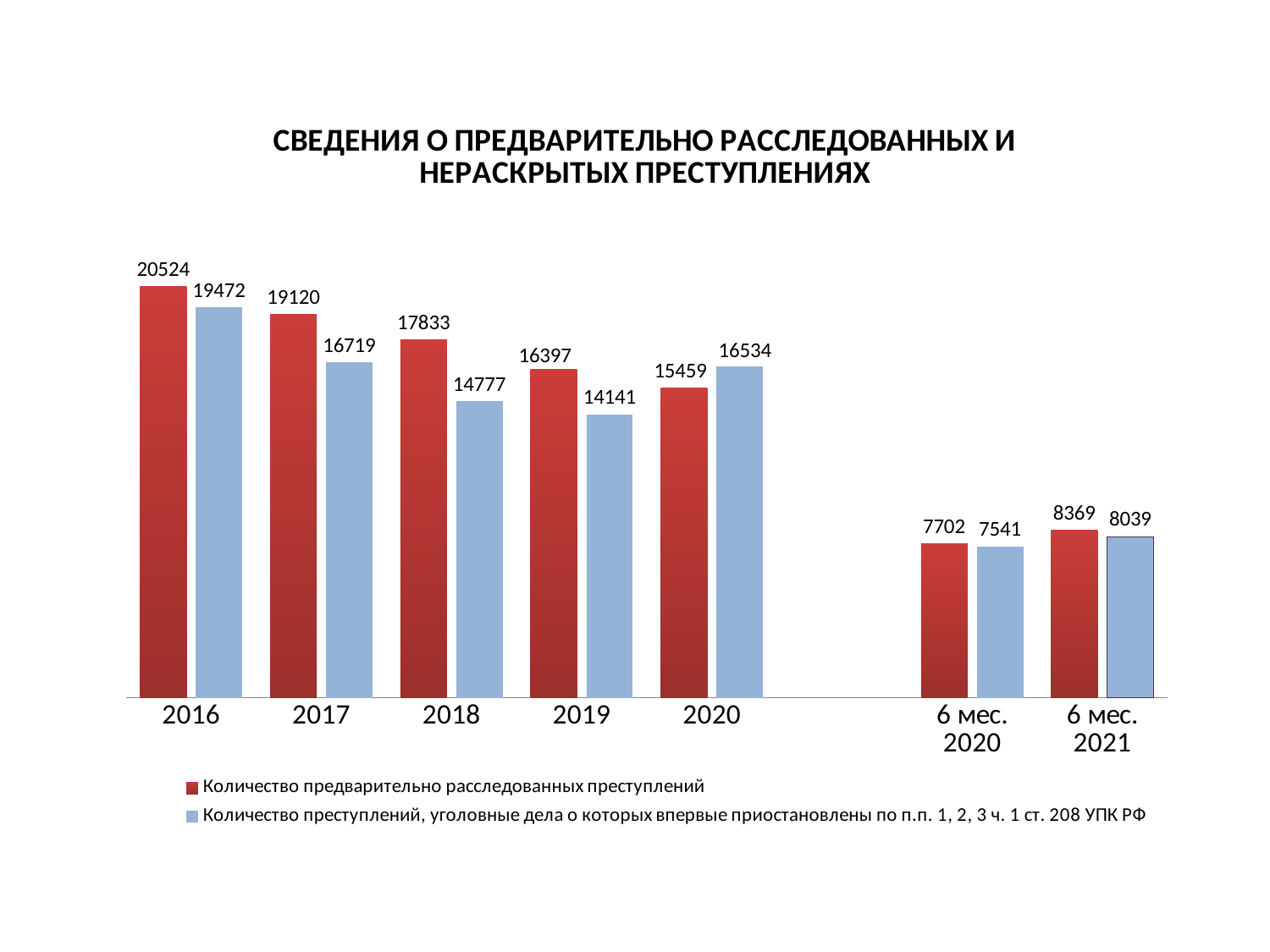
How many categories are shown on the x axis? 7 What is the value of the red series for 6 мес. 2021? 8369 What is the value of the blue series (crimes with cases first suspended under art. 208 УПК РФ) for 2019? 14141 How many series does the legend list? 2 What kind of chart is shown on the slide? bar chart In 2020, which series has the larger value: the red series or the blue series? the blue series (16534) What is the difference between the red and blue values for 2018? 3056 What is the number of preliminarily investigated crimes (red series) for 2016? 20524 What is the title of the chart? СВЕДЕНИЯ О ПРЕДВАРИТЕЛЬНО РАССЛЕДОВАННЫХ И НЕРАСКРЫТЫХ ПРЕСТУПЛЕНИЯХ Which category has the highest value for the red series (preliminarily investigated crimes)? 2016 Which category has the lowest value for the blue series? 6 мес. 2020 Does the red series rise or fall from 2016 to 2020? fall